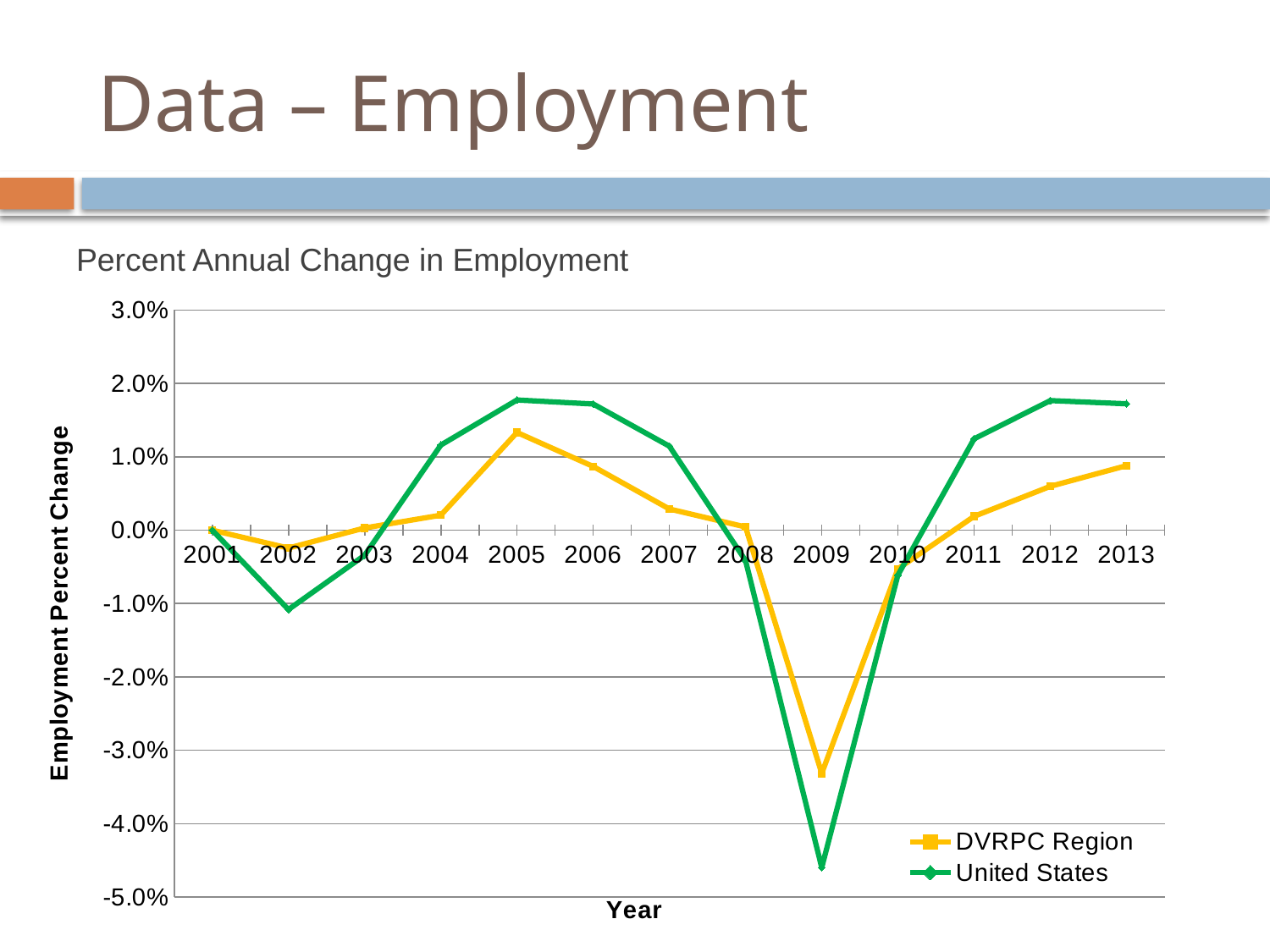
Is the DVRPC Region value for 2009 greater or less than -4.0%? greater What type of chart is shown on the slide? Line chart In which year does the DVRPC Region series reach its lowest value? 2009 Does the DVRPC Region series rise or fall from 2009 to 2013? rise Is the United States value for 2009 greater or less than -4.0%? less In which year does the DVRPC Region series reach its highest value? 2005 How many years are plotted along the x axis? 13 In 2002, which series has the higher value, DVRPC Region or United States? DVRPC Region How many series does the legend list? 2 In which year does the United States series reach its lowest value? 2009 Is the DVRPC Region value for 2005 greater or less than 1.0%? greater In 2005, which series has the higher value, DVRPC Region or United States? United States